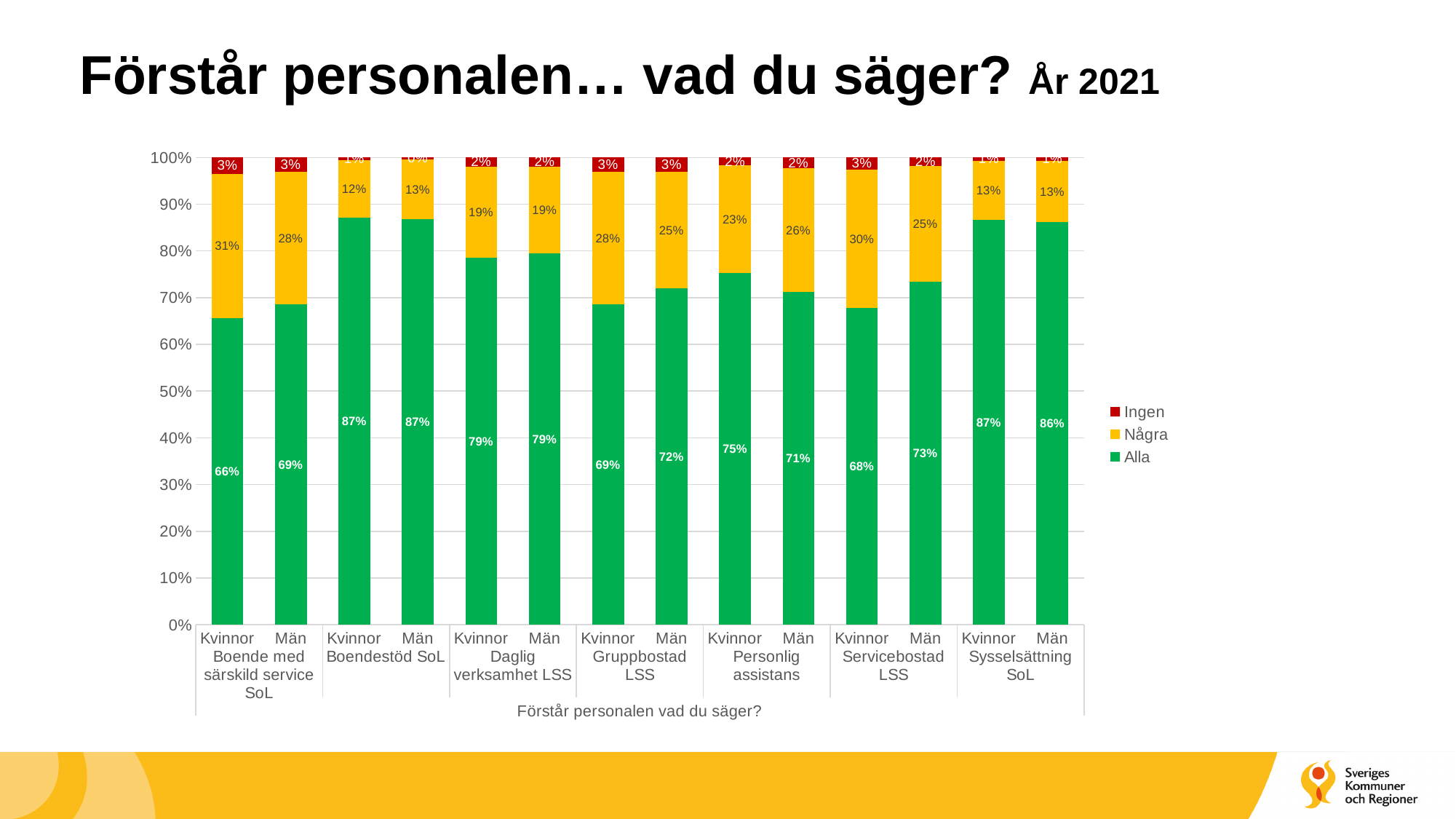
What is the 'Alla' value for Kvinnor in Boende med särskild service SoL? 66% What is the 'Några' value for Män in Personlig assistans? 26% Which bar has the lowest 'Alla' value? Kvinnor, Boende med särskild service SoL Which series is shown in green? Alla Which is larger, the 'Alla' value for Kvinnor or for Män in Servicebostad LSS? Män How many bars are plotted in the chart? 14 How many series does the legend list? 3 What is the 'Ingen' value for Kvinnor in Servicebostad LSS? 3% What kind of chart is shown on the slide? stacked bar chart What is the difference between the 'Alla' values for Kvinnor and Män in Personlig assistans? 4% What is the x-axis title of the chart? Förstår personalen vad du säger? Is the 'Alla' value for Män in Gruppbostad LSS greater or less than 80%? less